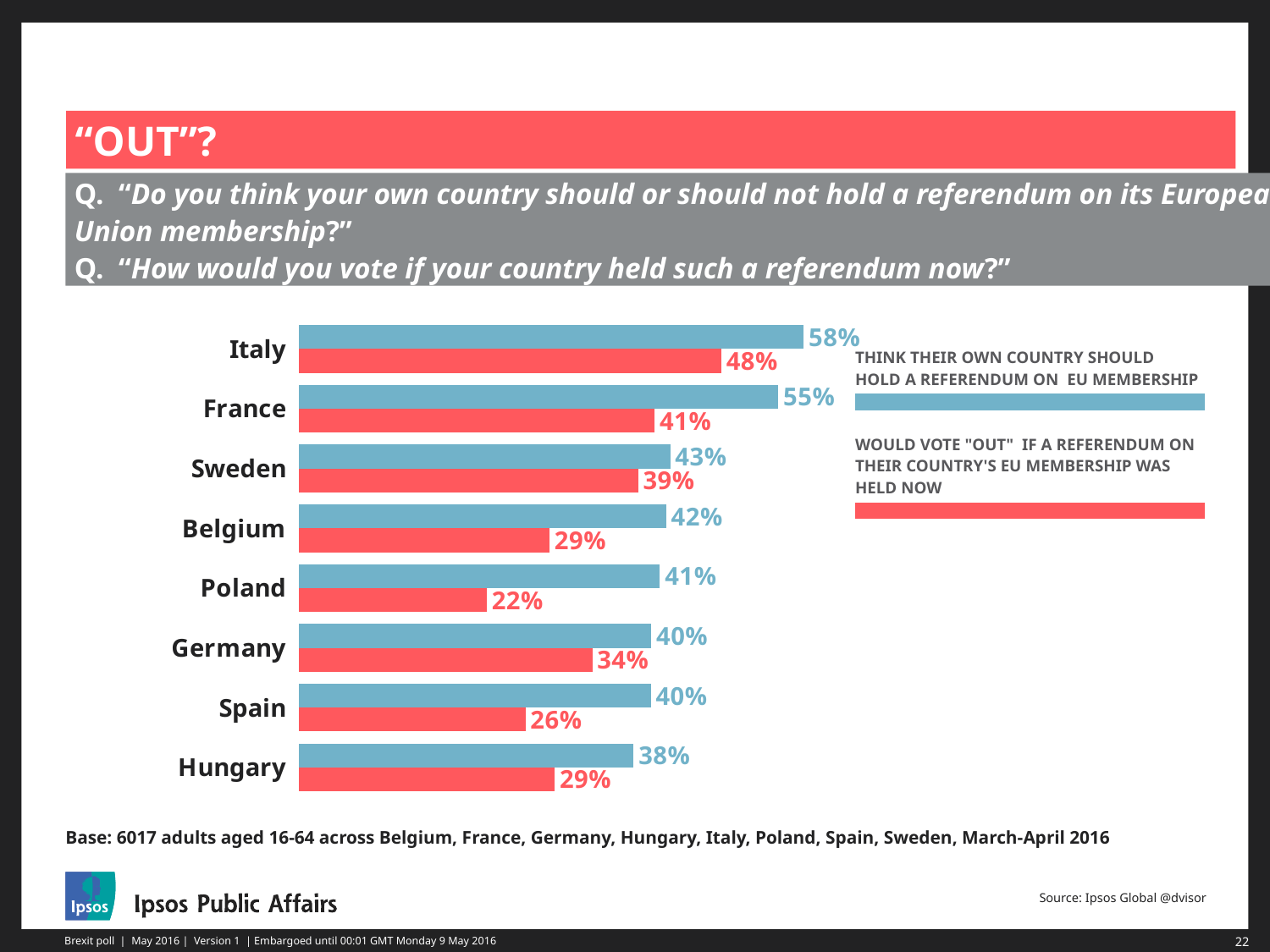
Which colour represents respondents who would vote "Out" if a referendum were held now? Red What kind of chart is shown on the slide? Bar chart How many countries are shown in the chart? 8 How many series does the legend list? 2 What is the difference between the share in France who think their country should hold a referendum and the share who would vote "Out"? 14 percentage points What percentage of respondents in Hungary think their own country should hold a referendum on EU membership? 38% What is the difference between Italy's and Sweden's share of respondents who would vote "Out"? 9 percentage points What percentage of respondents in Italy think their own country should hold a referendum on EU membership? 58% Which country has the lowest share of respondents who would vote "Out" if a referendum were held now? Poland Which is larger: the share in Germany who would vote "Out" or the share in Spain who would vote "Out"? Germany What percentage of respondents in Poland would vote "Out" if a referendum on their country's EU membership was held now? 22% Which country has the highest share of respondents who think their country should hold a referendum on EU membership? Italy